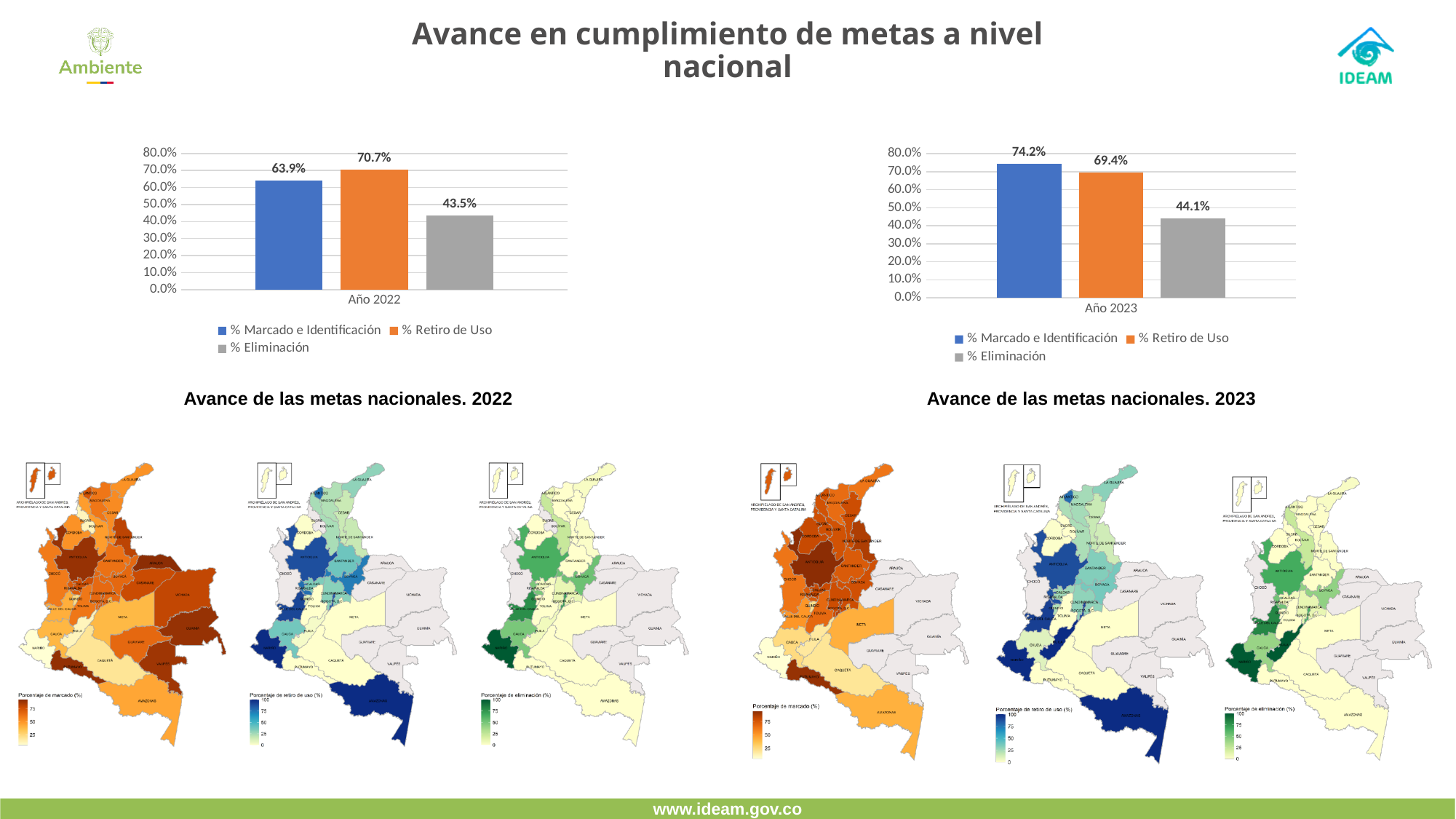
In the left chart (Año 2022), what is the difference between % Retiro de Uso and % Marcado e Identificación? 6.8 percentage points In the right chart (Año 2023), what colour is the bar for % Retiro de Uso? Orange In the left chart (Año 2022), which series has the highest value? % Retiro de Uso Which is larger: % Marcado e Identificación in the left chart (Año 2022) or % Marcado e Identificación in the right chart (Año 2023)? Año 2023 (74.2%) How many series does the legend of the left chart (Año 2022) list? 3 In the right chart (Año 2023), what is the value for % Marcado e Identificación? 74.2% In the left chart (Año 2022), what is the value for % Marcado e Identificación? 63.9% In the left chart (Año 2022), what is the value for % Retiro de Uso? 70.7% In the right chart (Año 2023), what is the difference between % Marcado e Identificación and % Retiro de Uso? 4.8 percentage points In the right chart (Año 2023), what is the value for % Eliminación? 44.1% What type of chart is the right chart (Año 2023)? Bar chart In the right chart (Año 2023), which series has the lowest value? % Eliminación